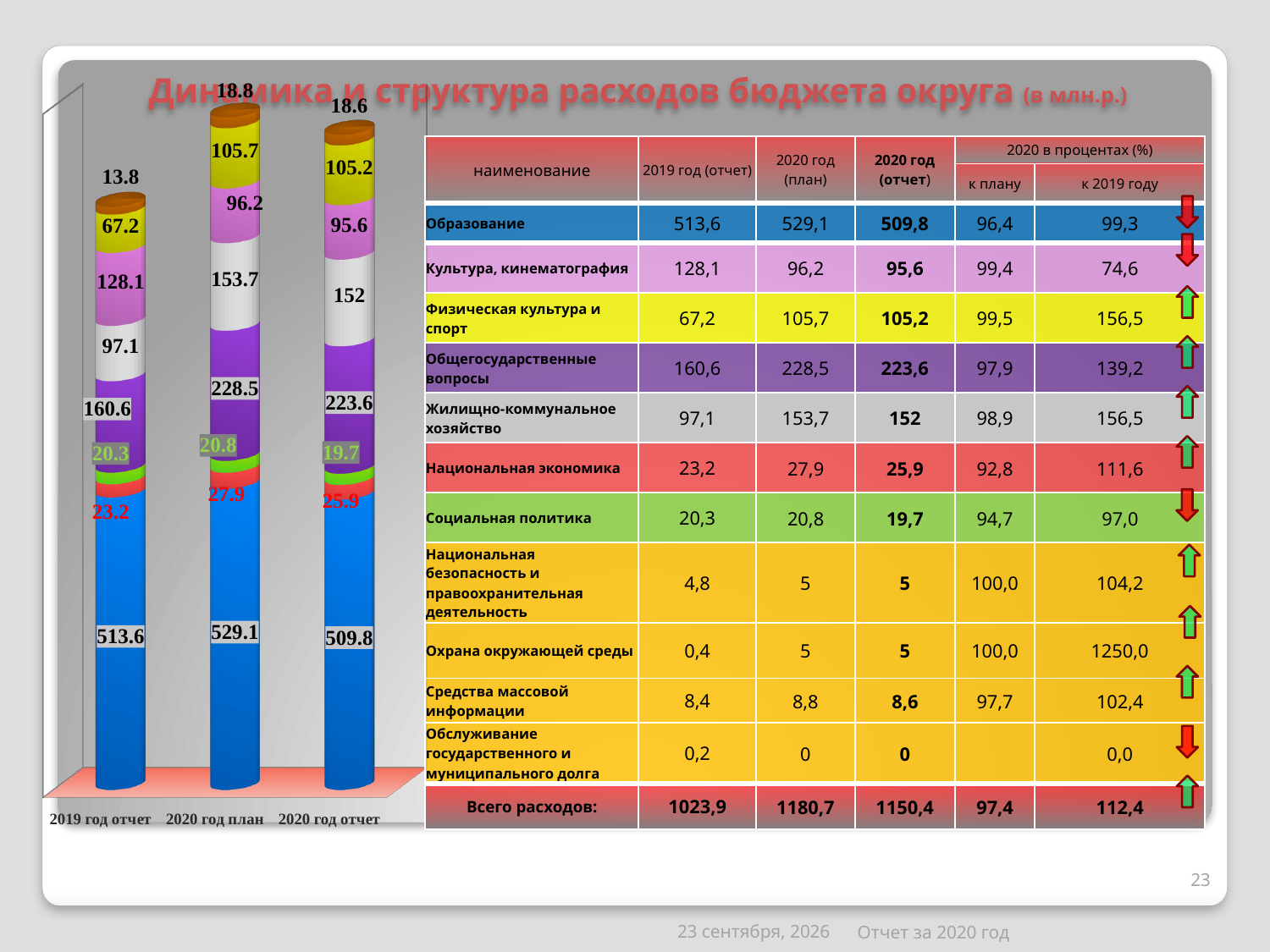
What are the three category labels along the x axis of the stacked bar chart? 2019 год отчет, 2020 год план, 2020 год отчет What kind of chart is shown on the left of the slide? stacked bar chart In the stacked bar chart, what is the value of the purple segment of the 2020 год отчет bar? 223.6 In the stacked bar chart, what is the value of the white segment of the 2020 год отчет bar? 152 In the stacked bar chart, which bar has the larger purple segment: 2019 год отчет or 2020 год план? 2020 год план How many bars does the stacked bar chart on the left contain? 3 In the stacked bar chart, what is the difference between the purple segments of the 2020 год план bar (228.5) and the 2020 год отчет bar (223.6)? 4.9 In the stacked bar chart, what is the value of the bottom blue segment of the 2019 год отчет bar? 513.6 In the stacked bar chart, what is the difference between the bottom blue segments of the 2020 год план bar (529.1) and the 2020 год отчет bar (509.8)? 19.3 In the stacked bar chart, which bar has the largest bottom blue segment? 2020 год план In the stacked bar chart, what value is labelled at the top of the 2019 год отчет bar? 13.8 In the stacked bar chart, what is the value of the bottom blue segment of the 2020 год план bar? 529.1